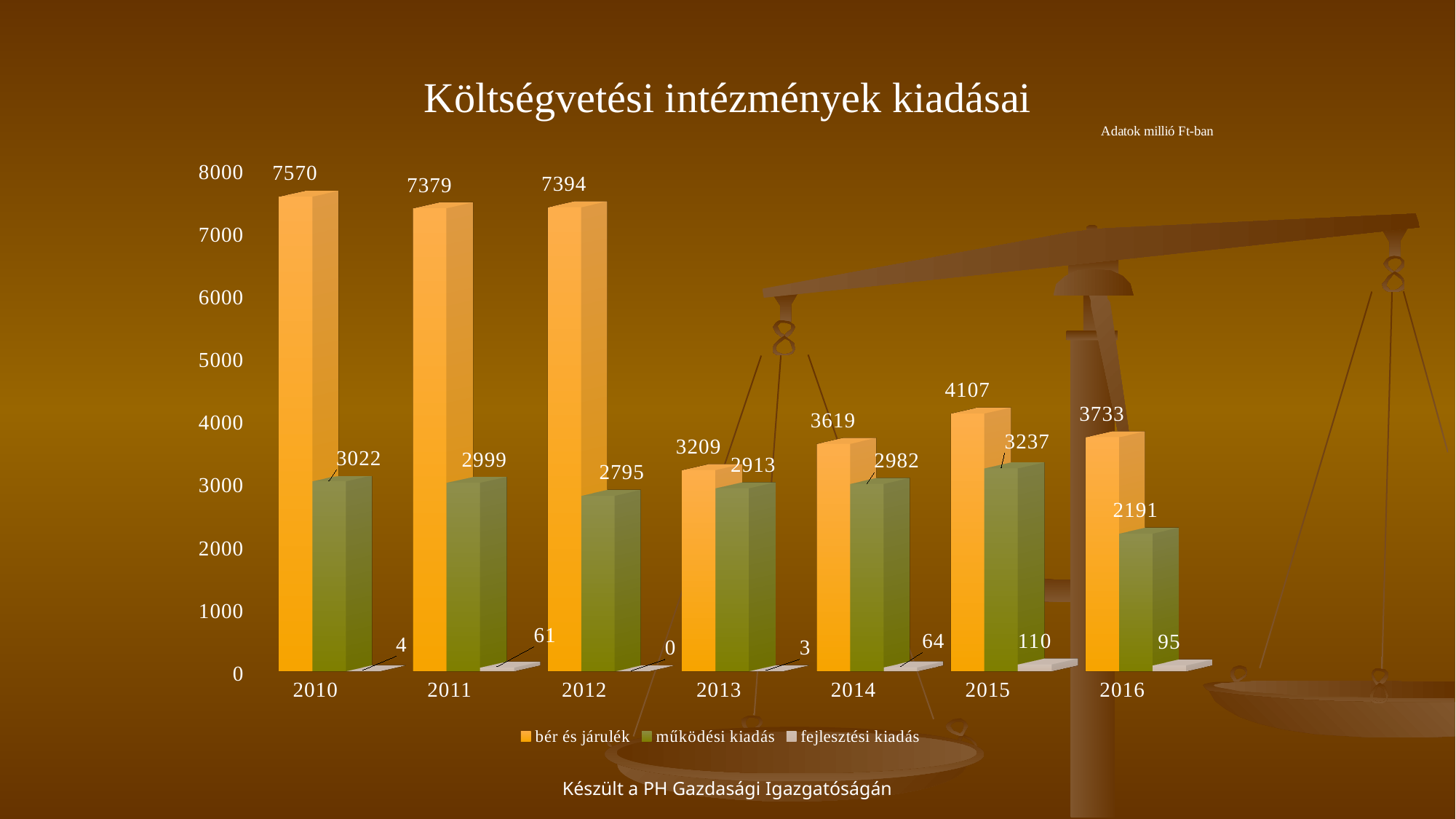
What is the value of működési kiadás for 2016? 2191 What is the value of fejlesztési kiadás for 2015? 110 What is the difference between bér és járulék in 2010 and in 2016? 3837 What is the title of the chart? Költségvetési intézmények kiadásai In which year is bér és járulék the highest? 2010 What is the value of bér és járulék for 2010? 7570 How many years are shown on the x axis? 7 What kind of chart is shown on the slide? bar chart What is the total of the three series for 2016? 6019 How many series does the legend list? 3 In which year is bér és járulék the lowest? 2013 Which is larger: működési kiadás in 2015 or in 2014? 2015